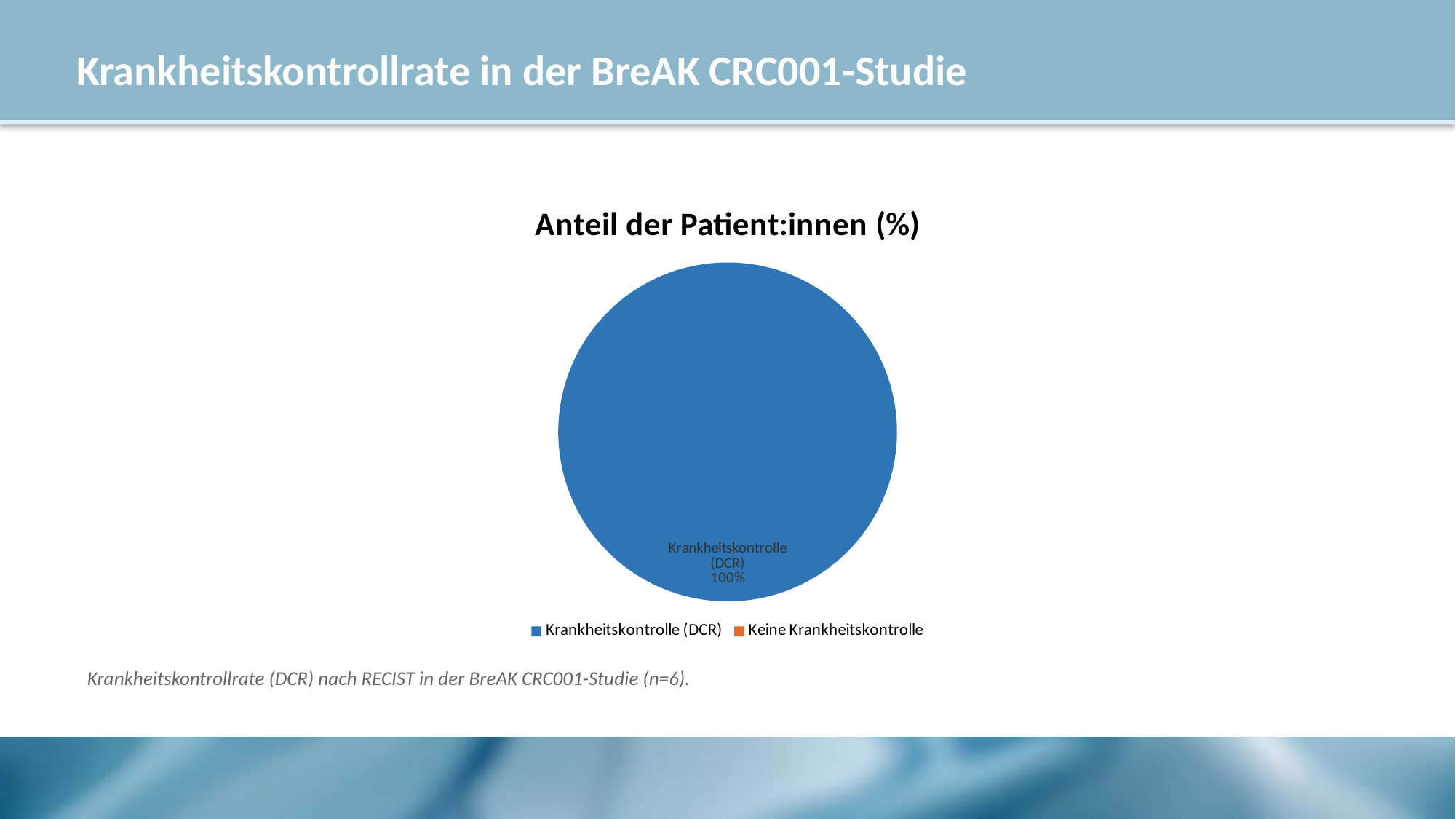
Which category has the smallest share of the pie? Keine Krankheitskontrolle What is the title of the chart? Anteil der Patient:innen (%) What colour is the Krankheitskontrolle (DCR) slice? blue How many entries does the legend list? 2 Is the share for Krankheitskontrolle (DCR) greater or less than 50%? greater What value is printed on the Krankheitskontrolle (DCR) slice? 100% Which is larger, the share for Krankheitskontrolle (DCR) or the share for Keine Krankheitskontrolle? Krankheitskontrolle (DCR) What share of the pie does Krankheitskontrolle (DCR) take? 100% What kind of chart is shown on the slide? pie chart Which category has the largest share of the pie? Krankheitskontrolle (DCR)